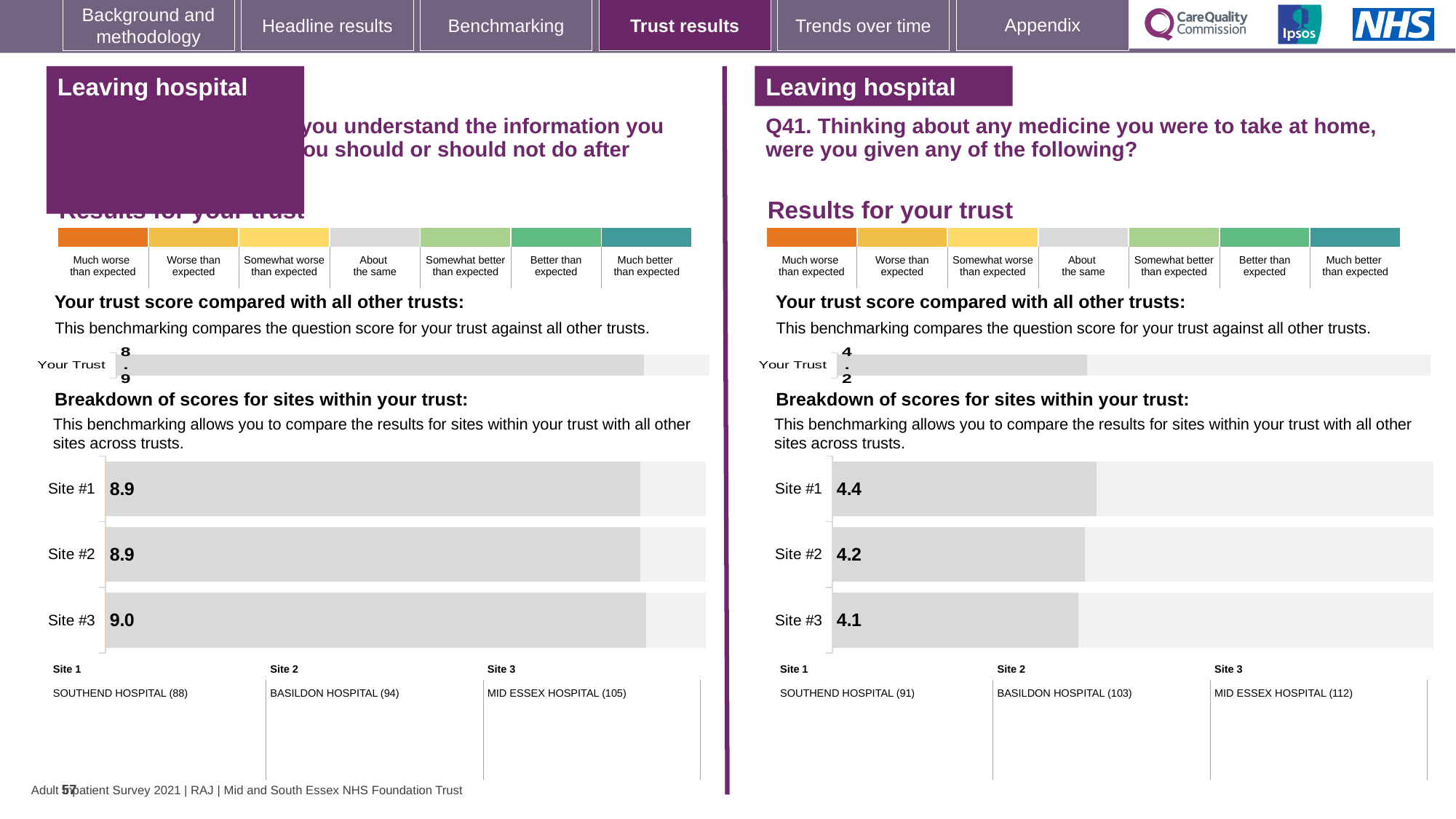
On the right-hand (Q41) 'Your Trust' chart, what is the trust score shown? 4.2 What kind of chart is the left-hand site breakdown chart? Bar chart On the right-hand (Q41) site breakdown chart, what is the score for Site #1? 4.4 On the left-hand site breakdown chart, what is the score for Site #2? 8.9 On the left-hand 'Your Trust' chart, what is the trust score shown? 8.9 How many sites are shown on the right-hand (Q41) site breakdown chart? 3 On the right-hand (Q41) site breakdown chart, what is the score for Site #3? 4.1 On the right-hand (Q41) site breakdown chart, what is the difference between the scores for Site #1 and Site #3? 0.3 On the left-hand site breakdown chart, what is the score for Site #3? 9.0 On the right-hand (Q41) site breakdown chart, which site has the lowest score? Site #3 On the left-hand site breakdown chart, what is the difference between the scores for Site #3 and Site #1? 0.1 On the right-hand (Q41) site breakdown chart, which site has the highest score? Site #1